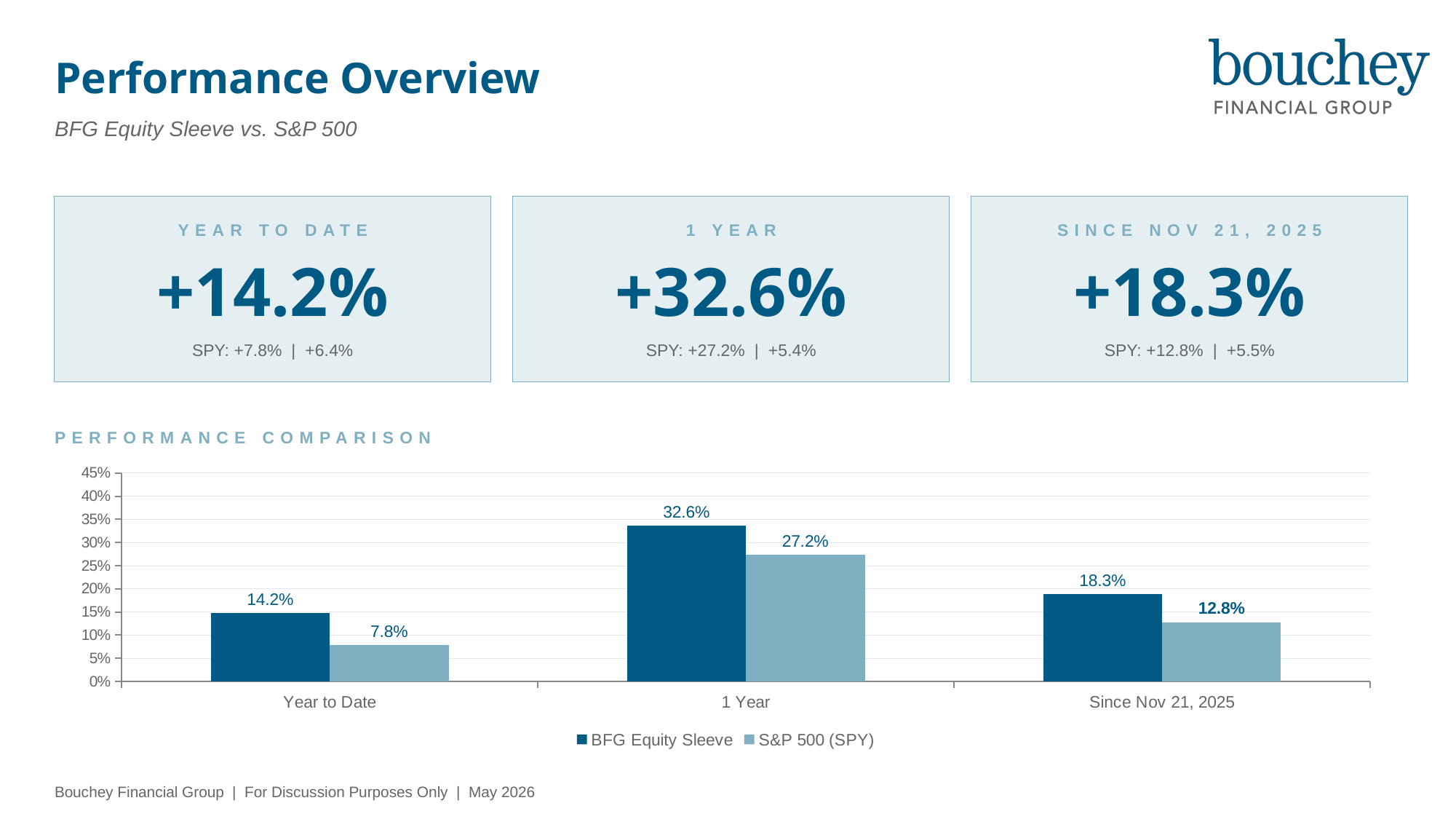
What is the value for S&P 500 (SPY) in the Year to Date category? 7.8% Is the value for S&P 500 (SPY) in the 1 Year category greater or less than 25%? greater Which is larger in the Since Nov 21, 2025 category: BFG Equity Sleeve or S&P 500 (SPY)? BFG Equity Sleeve What is the value for BFG Equity Sleeve in the 1 Year category? 32.6% What kind of chart is shown on the slide? Bar chart Which category has the lowest value for S&P 500 (SPY)? Year to Date What is the value for S&P 500 (SPY) in the Since Nov 21, 2025 category? 12.8% How many categories are shown on the x axis of the chart? 3 How many series does the chart legend list? 2 What is the difference between BFG Equity Sleeve and S&P 500 (SPY) in the Year to Date category? 6.4% What is the difference between BFG Equity Sleeve and S&P 500 (SPY) in the 1 Year category? 5.4% Which category has the highest value for BFG Equity Sleeve? 1 Year